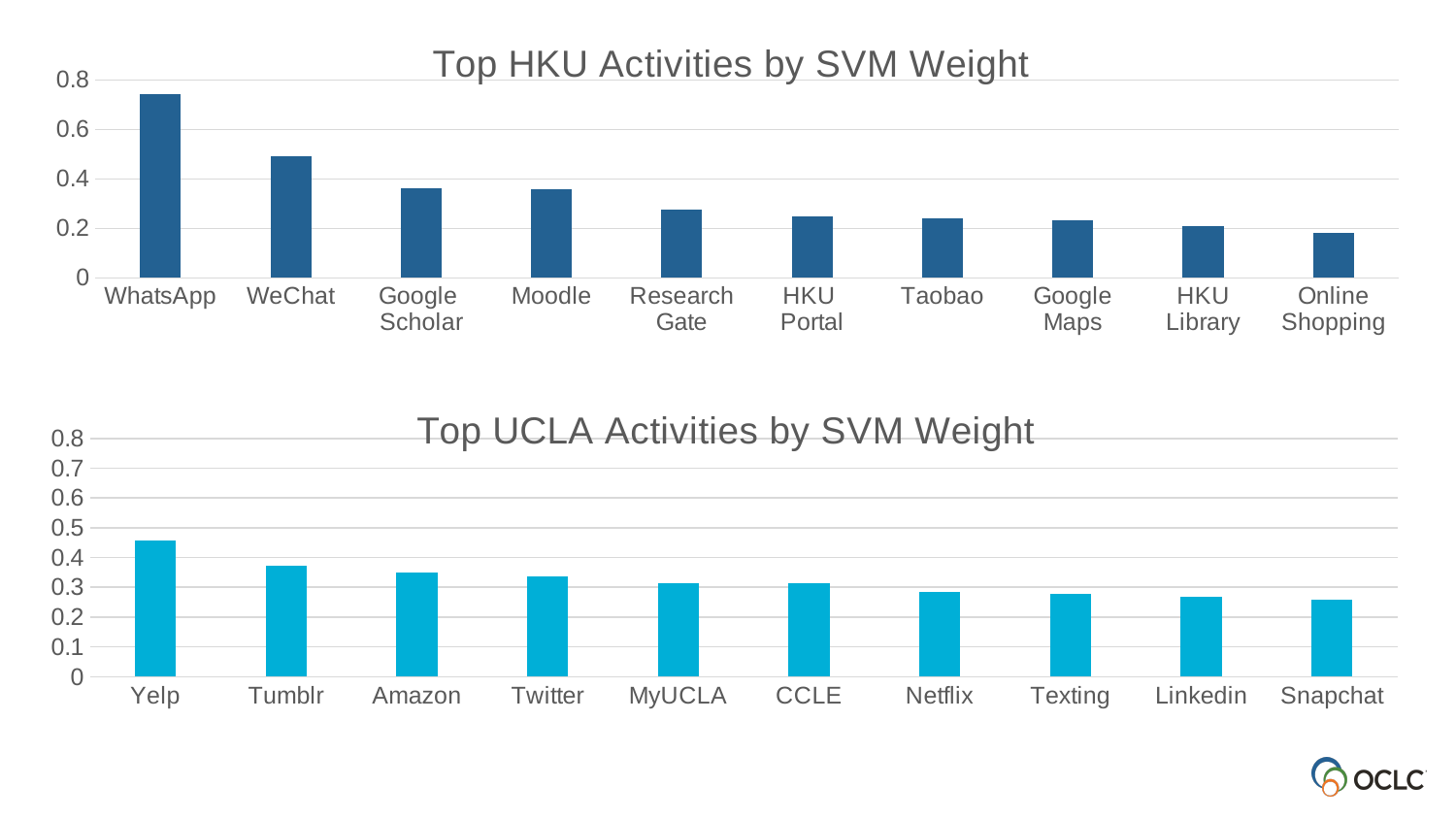
In the 'Top UCLA Activities by SVM Weight' chart, is the value for Yelp greater or less than 0.4? greater In the 'Top HKU Activities by SVM Weight' chart, how many activities are plotted? 10 In the 'Top HKU Activities by SVM Weight' chart, is the value for WhatsApp greater or less than 0.6? greater In the 'Top HKU Activities by SVM Weight' chart, is the value for WeChat greater or less than 0.6? less In the 'Top HKU Activities by SVM Weight' chart, which activity has the lowest SVM weight? Online Shopping In the 'Top HKU Activities by SVM Weight' chart, do the values rise or fall from left to right? fall In the 'Top HKU Activities by SVM Weight' chart, which activity has the highest SVM weight? WhatsApp In the 'Top UCLA Activities by SVM Weight' chart, how many activities are plotted? 10 What kind of chart is the 'Top UCLA Activities by SVM Weight' chart? bar chart In the 'Top UCLA Activities by SVM Weight' chart, which activity has the highest SVM weight? Yelp In the 'Top HKU Activities by SVM Weight' chart, which has a higher SVM weight, WhatsApp or WeChat? WhatsApp